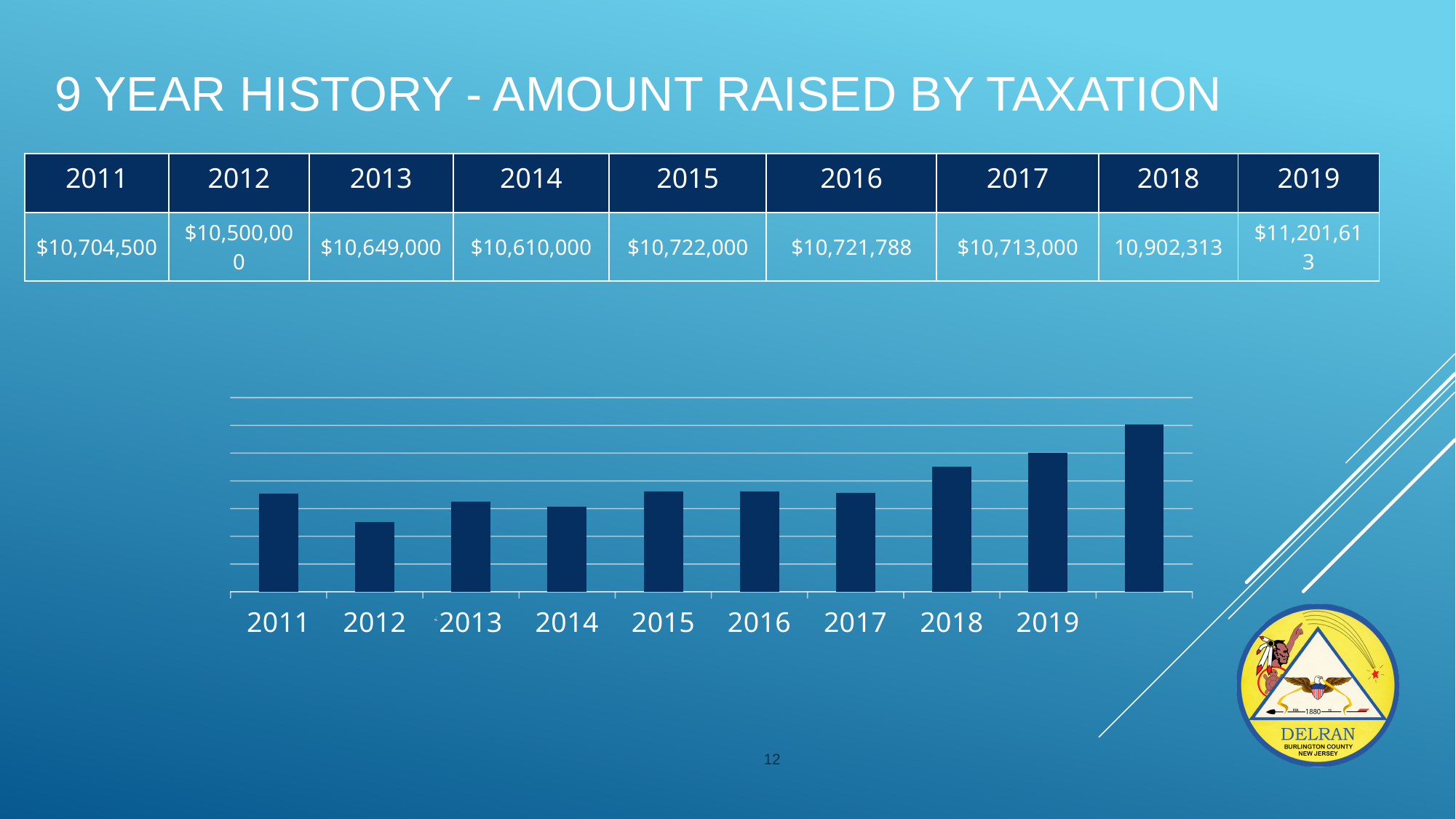
Which bar is taller, 2011 or 2012? 2011 What kind of chart is shown on the slide? bar chart Which year has the shortest bar in the chart? 2012 According to the table, what was the amount raised by taxation in 2019? $11,201,613 What is the title of the slide containing the chart? 9 YEAR HISTORY - AMOUNT RAISED BY TAXATION According to the table, what was the amount raised by taxation in 2015? $10,722,000 According to the table, what was the amount raised by taxation in 2012? $10,500,000 How many year labels are shown on the x axis of the chart? 9 Using the table values, how much more was raised in 2019 than in 2018? 299,300 Is the tallest bar in the chart on the left or the right side of the chart? right Do the bars in the chart generally rise or fall from left to right? rise Which bar is taller, 2017 or 2018? 2018